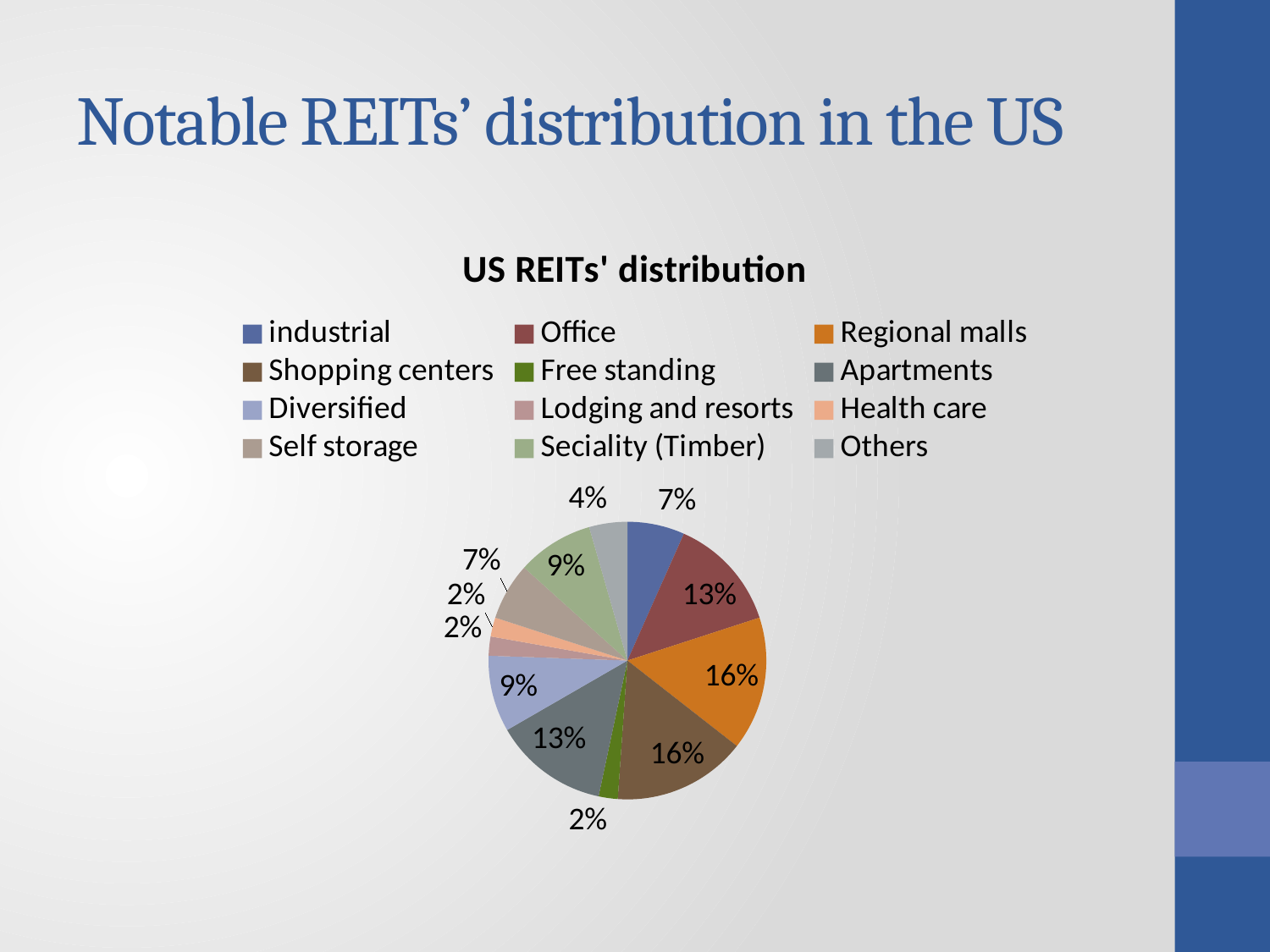
What is the title of the chart? US REITs' distribution What share of the pie is Others? 4% What share of the pie is Office? 13% What share of the pie is Diversified? 9% Which is larger, the share for Office or the share for Diversified? Office What share of the pie is Free standing? 2% How many categories does the legend list? 12 What is the difference in percentage points between Regional malls and Office? 3 What share of the pie is Apartments? 13% What type of chart is shown on the slide? Pie chart What colour represents Regional malls in the chart? Orange What share of the pie is Regional malls? 16%